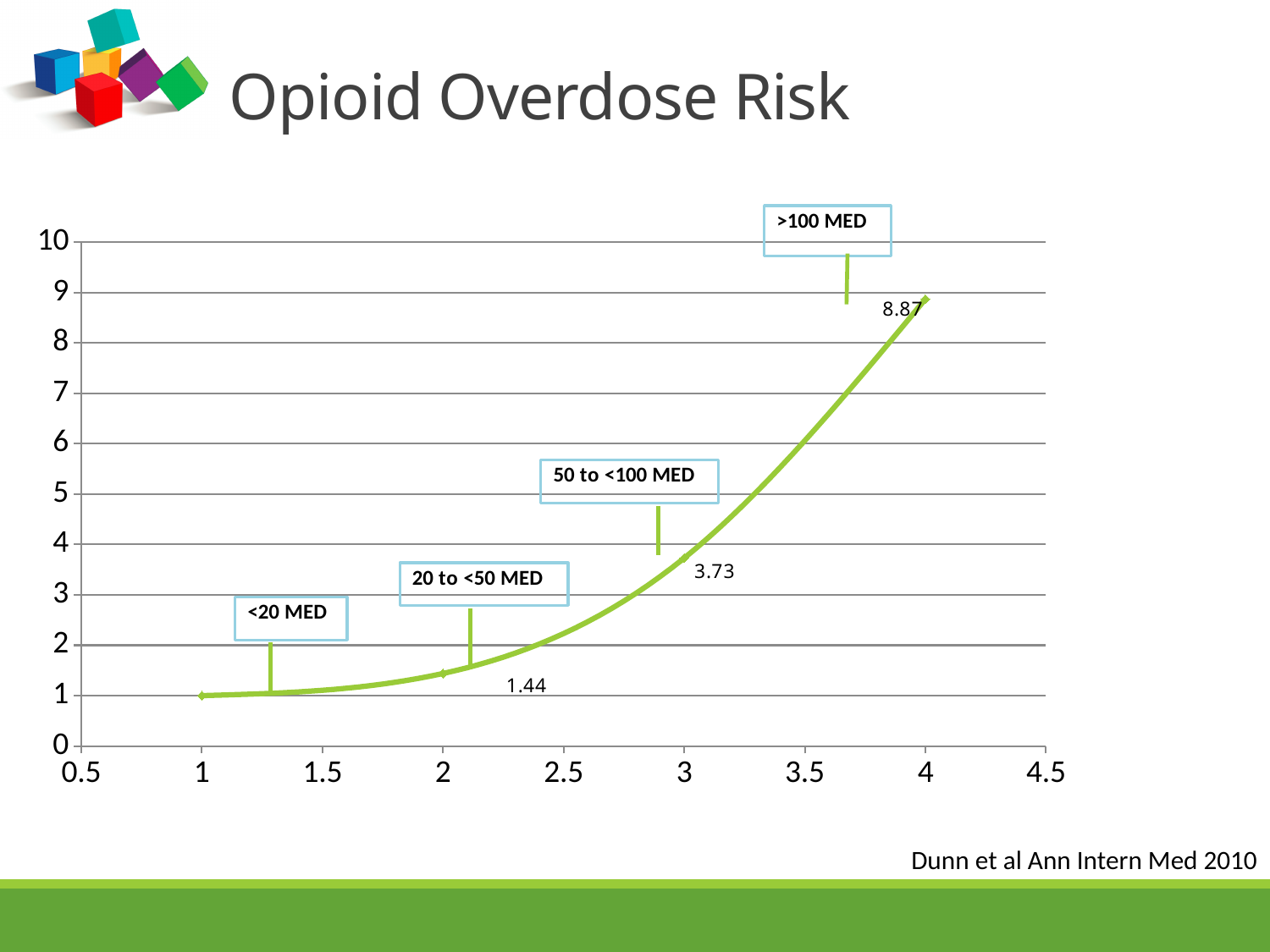
What is the data label on the point at x = 2? 1.44 Do the values rise or fall as x increases from 1 to 4? rise What is the difference between the values at x = 3 and x = 2? 2.29 How many data points are plotted on the line? 4 What kind of chart is shown on the slide? line chart What is the data label on the point at x = 4? 8.87 Which annotation label is attached to the highest point on the curve? >100 MED Which x value has the highest plotted value? 4 What is the difference between the values at x = 4 and x = 3? 5.14 Is the value at x = 1 greater or less than 2? less Which is larger, the value at x = 2 or the value at x = 3? x = 3 (3.73) What is the data label on the point at x = 3? 3.73